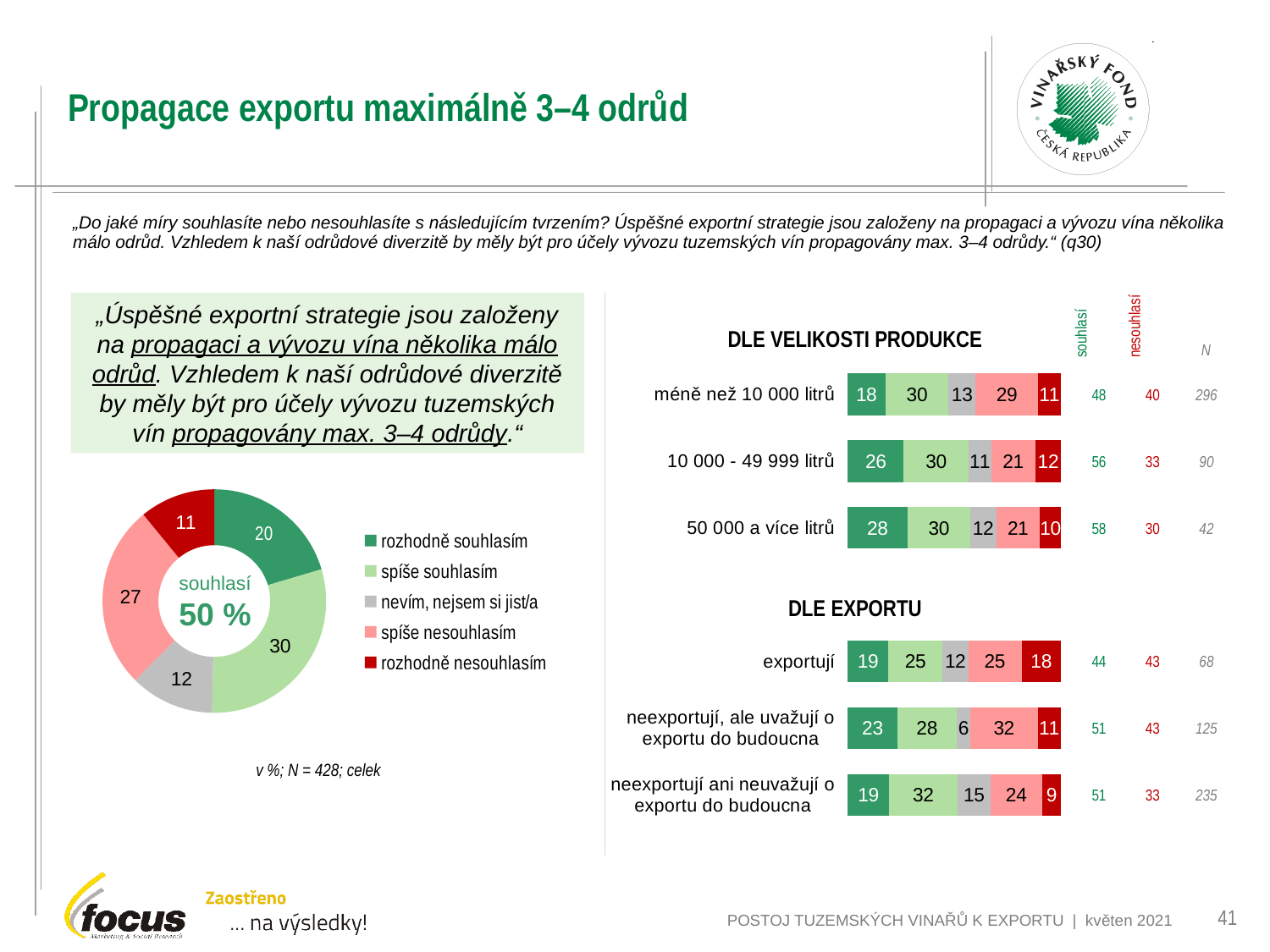
In the donut chart on the left, what is the combined share shown in the centre for "souhlasí"? 50 % In the donut chart on the left, which response category has the smallest share? rozhodně nesouhlasím In the "DLE EXPORTU" chart, what is the "rozhodně nesouhlasím" value for "exportují"? 18 In the "DLE VELIKOSTI PRODUKCE" chart, what is the value of "rozhodně souhlasím" for "50 000 a více litrů"? 28 What type of chart is used for the "DLE EXPORTU" section on the right? stacked bar chart In the donut chart on the left, which response category has the largest share? spíše souhlasím In the donut chart on the left, what percentage of respondents answered "rozhodně souhlasím"? 20 In the "DLE VELIKOSTI PRODUKCE" chart, which production-size group has the highest "rozhodně souhlasím" value? 50 000 a více litrů In the "DLE VELIKOSTI PRODUKCE" chart, what is the difference between the "spíše nesouhlasím" values for "méně než 10 000 litrů" and "10 000 - 49 999 litrů"? 8 In the "DLE EXPORTU" chart, which group has the lowest "nevím, nejsem si jist/a" value? neexportují, ale uvažují o exportu do budoucna In the donut chart on the left, how many response categories does the legend list? 5 In the "DLE EXPORTU" chart, is the "spíše nesouhlasím" value larger for "exportují" or for "neexportují, ale uvažují o exportu do budoucna"? neexportují, ale uvažují o exportu do budoucna